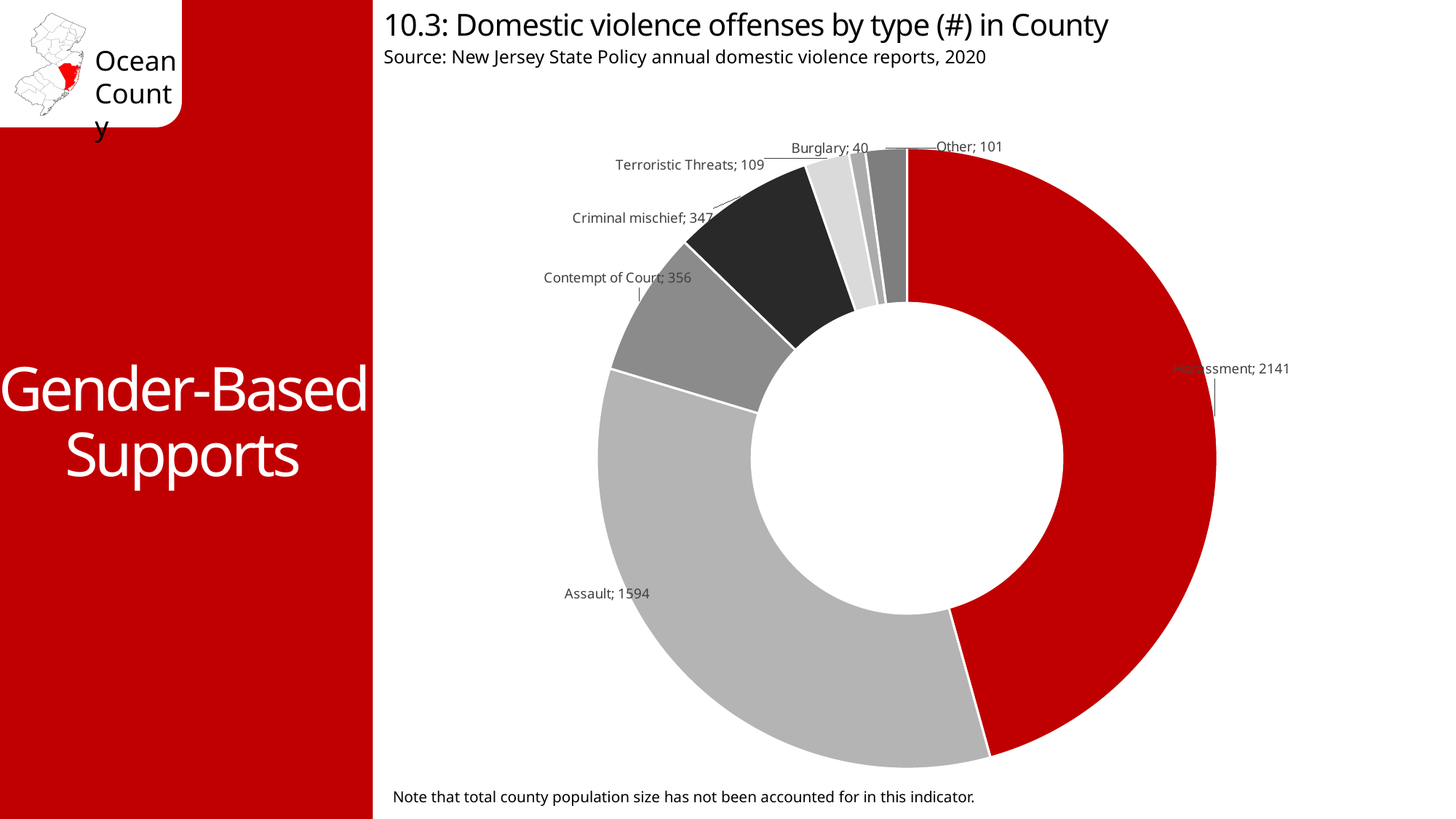
What is the difference between the Other and Burglary counts? 61 How many Assault offenses does the chart show? 1594 What kind of chart is shown on the slide? doughnut chart How many offense types are shown in the chart? 7 What value is shown for Contempt of Court? 356 Which offense type has the smallest number of offenses? Burglary What is the number of Harassment offenses shown in the chart? 2141 What is the source cited for the chart? New Jersey State Policy annual domestic violence reports, 2020 Which is larger, Contempt of Court or Criminal mischief? Contempt of Court What is the difference between the Harassment and Assault counts? 547 What value is shown for Burglary? 40 Which offense type has the largest number of offenses? Harassment